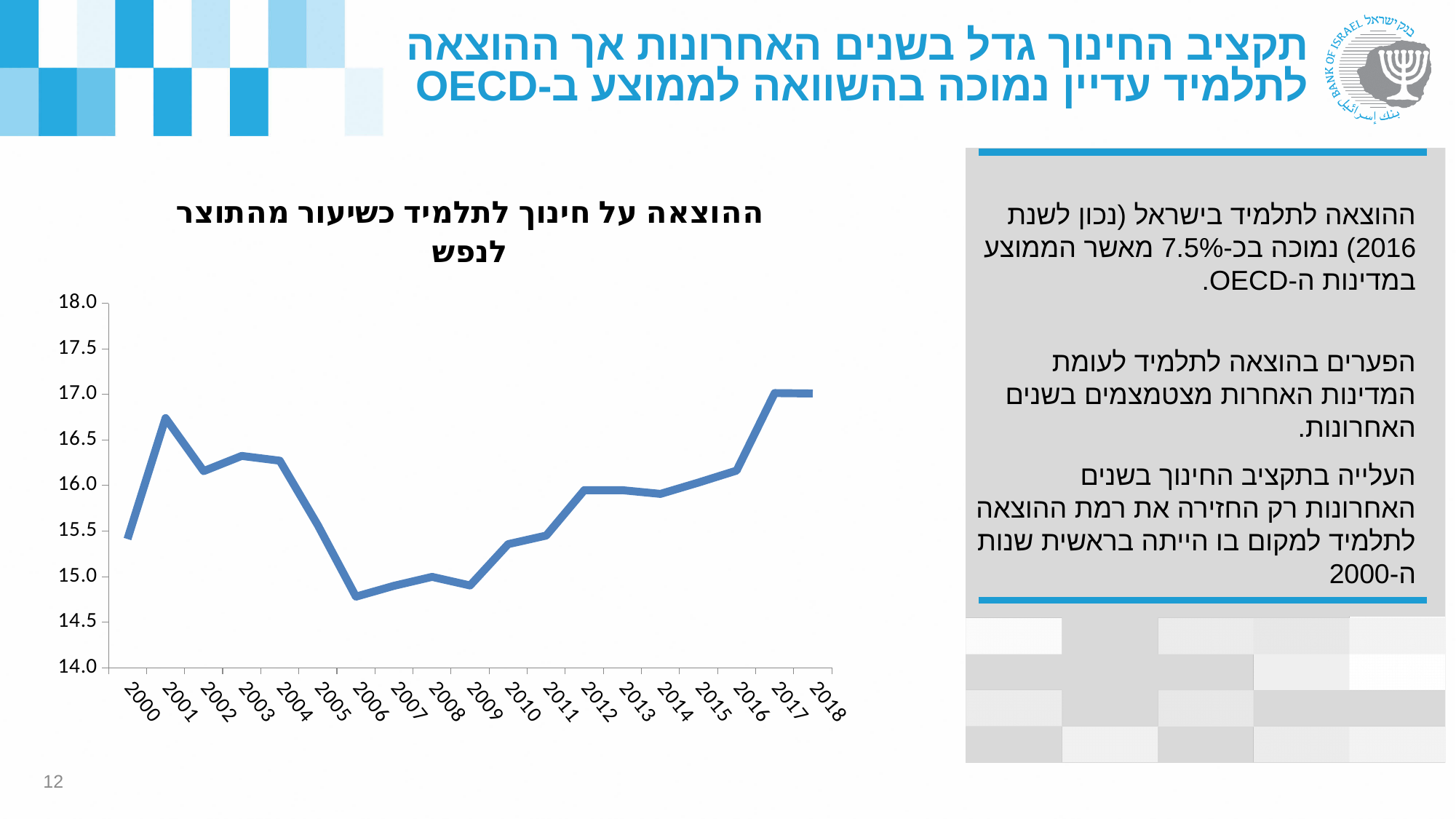
Is the value for 2006 greater or less than 15.0? less Which year has the larger value, 2000 or 2001? 2001 Is the value for 2001 greater or less than 16.5? greater Which year has the larger value, 2006 or 2016? 2016 How many years are plotted on the x axis of the chart? 19 Do the values rise or fall between 2009 and 2017? rise What kind of chart is shown on the slide? line chart Do the values rise or fall between 2001 and 2006? fall Is the value for 2017 greater or less than 16.5? greater Which year has the lowest value in the chart? 2006